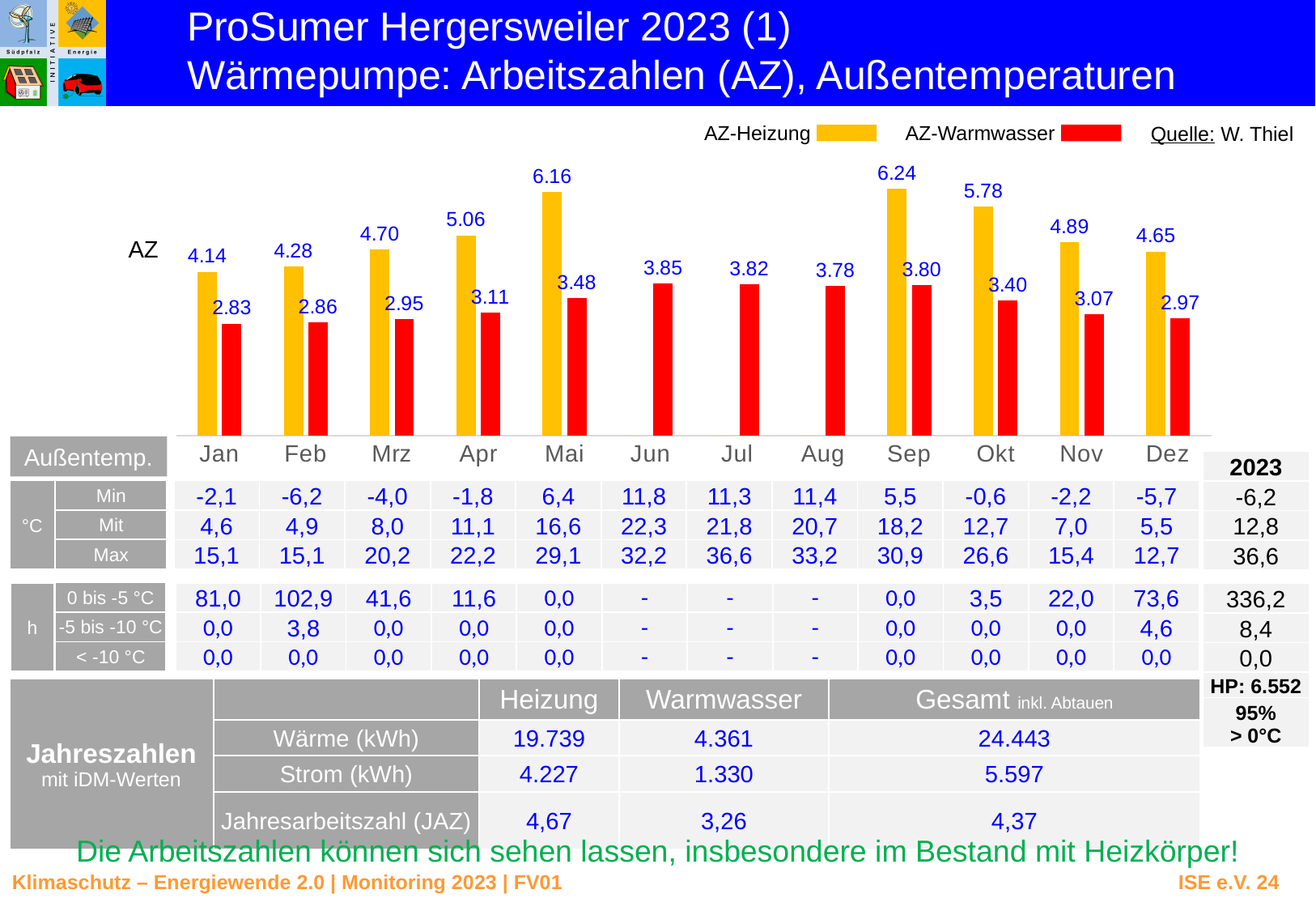
What is the difference between the AZ-Heizung and AZ-Warmwasser values in Okt? 2.38 How many months are shown on the x axis of the chart? 12 What is the AZ-Heizung value for Mai? 6.16 Which month has the lowest AZ-Warmwasser value? Jan Do the AZ-Heizung values rise or fall from Jan to Mai? rise Which colour represents AZ-Warmwasser in the chart? red How many series does the chart legend list? 2 What is the AZ-Warmwasser value for Jan? 2.83 Which month has the highest AZ-Heizung value? Sep What kind of chart is shown on the slide? bar chart Which is larger, the AZ-Heizung value for Apr or the AZ-Heizung value for Nov? Apr What is the AZ-Warmwasser value for Jun? 3.85